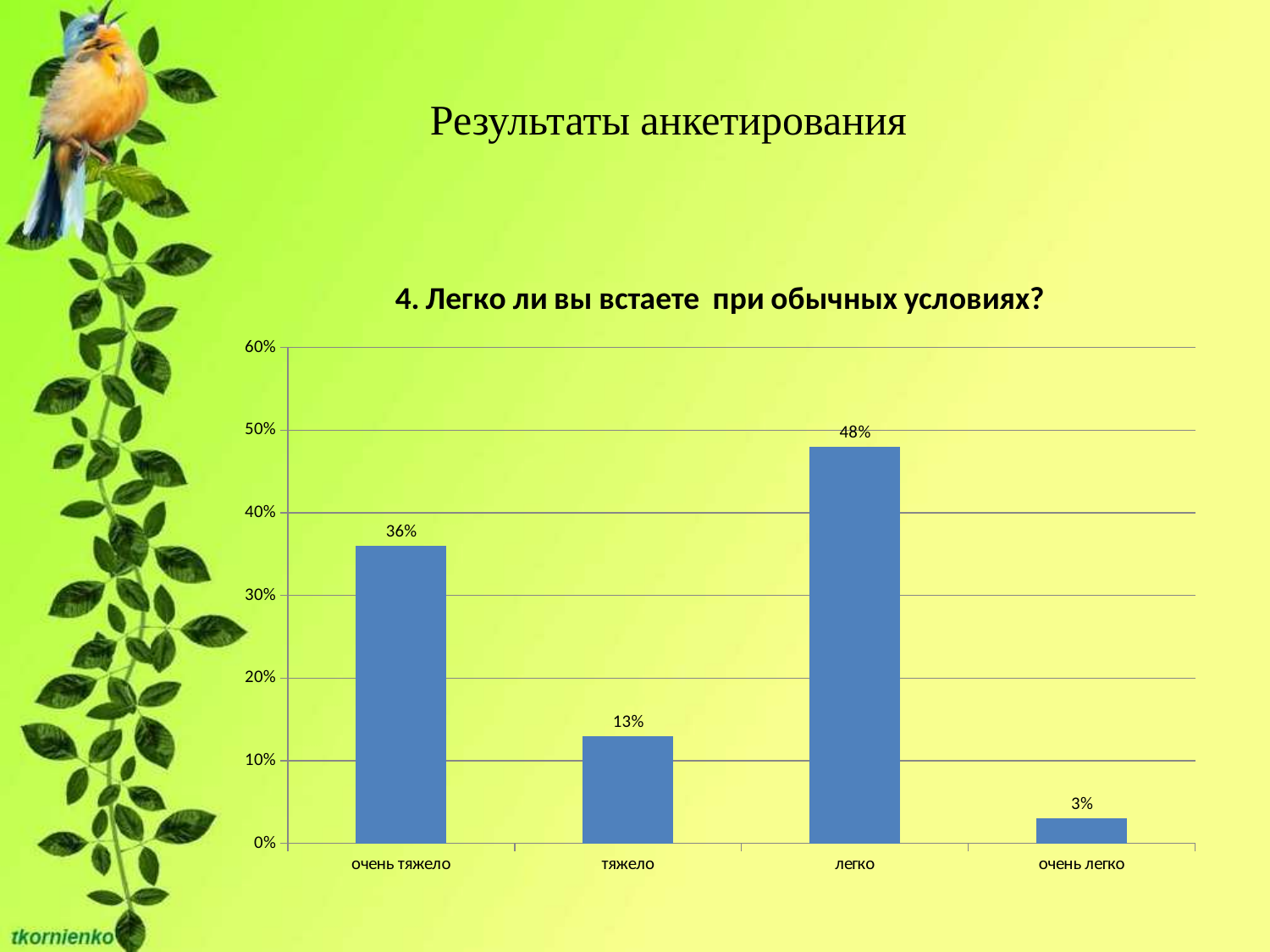
What kind of chart is shown on the slide? bar chart What is the value for "очень легко"? 3% Is the value for "легко" greater or less than 40%? greater What is the title of the chart? 4. Легко ли вы встаете при обычных условиях? What is the value for "легко"? 48% Which category has the lowest value? очень легко Which category has the highest value? легко How many categories are shown on the x axis? 4 What is the difference between the values for "легко" and "очень тяжело"? 12% What is the value for "тяжело"? 13% Which is larger, the value for "тяжело" or the value for "очень тяжело"? очень тяжело What is the value for "очень тяжело"? 36%